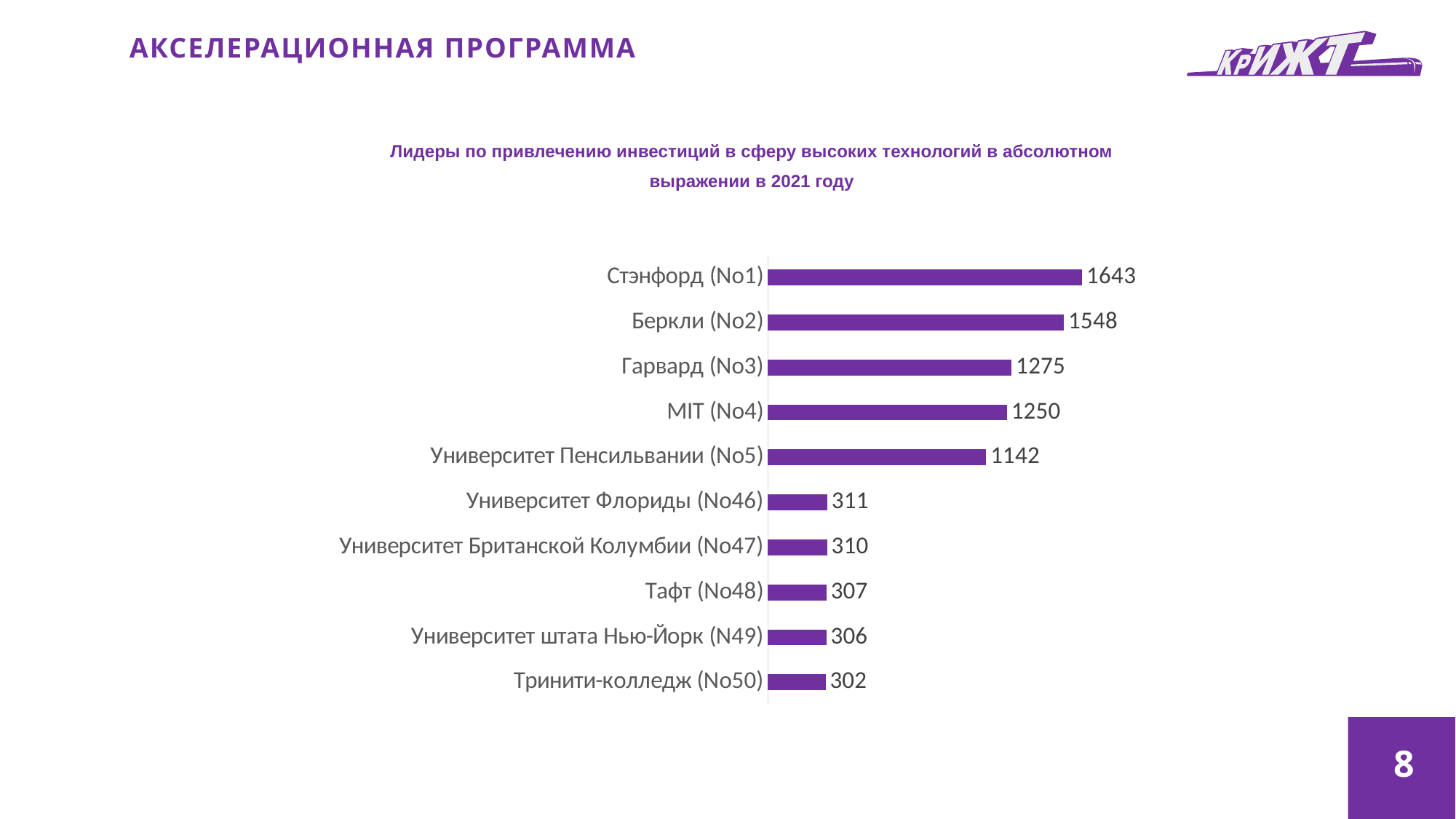
How many categories are shown in the chart? 10 Which is larger, the value for Университет Флориды (No46) or the value for Университет Пенсильвании (No5)? Университет Пенсильвании (No5) Which category has the lowest value? Тринити-колледж (No50) What is the difference between the values for Гарвард (No3) and MIT (No4)? 25 What kind of chart is shown on the slide? Bar chart What is the difference between the values for Стэнфорд (No1) and Беркли (No2)? 95 Which category has the highest value? Стэнфорд (No1) What is the value for Университет Пенсильвании (No5)? 1142 What colour are the bars in the chart? Purple What is the title of the chart? Лидеры по привлечению инвестиций в сферу высоких технологий в абсолютном выражении в 2021 году What is the value for Тринити-колледж (No50)? 302 What is the value for Стэнфорд (No1)? 1643